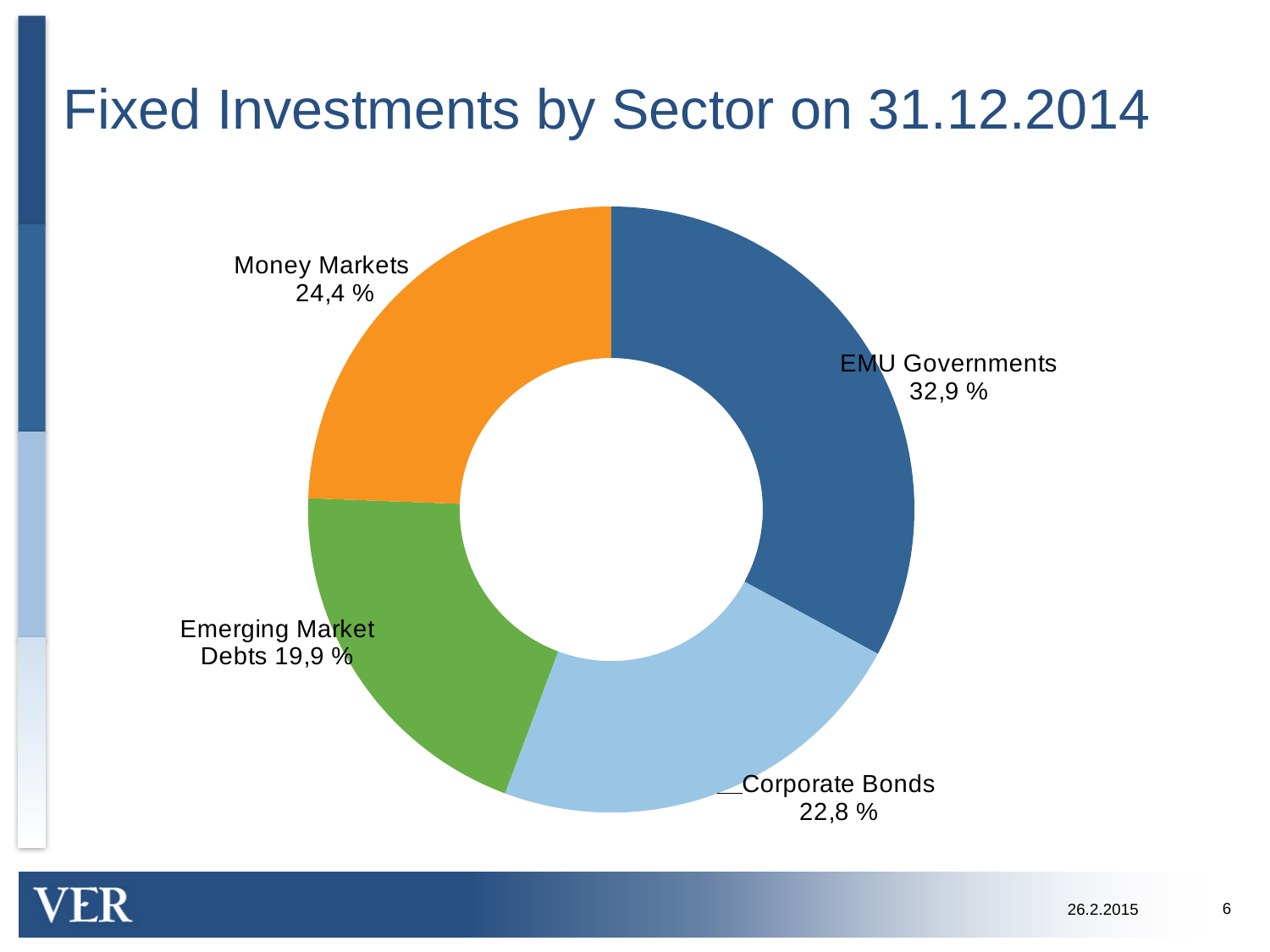
Which sector has the smallest share of fixed investments? Emerging Market Debts What share of fixed investments is in Emerging Market Debts? 19,9 % What is the title of the slide? Fixed Investments by Sector on 31.12.2014 How many sectors are shown in the chart? 4 What share of fixed investments is in Money Markets? 24,4 % What is the difference in percentage points between the EMU Governments share and the Emerging Market Debts share? 13,0 What share of fixed investments is in EMU Governments? 32,9 % What kind of chart is shown on the slide? Doughnut (pie) chart Which has a larger share, Money Markets or Corporate Bonds? Money Markets What share of fixed investments is in Corporate Bonds? 22,8 % What is the difference in percentage points between the Money Markets share and the Corporate Bonds share? 1,6 Which sector has the largest share of fixed investments? EMU Governments